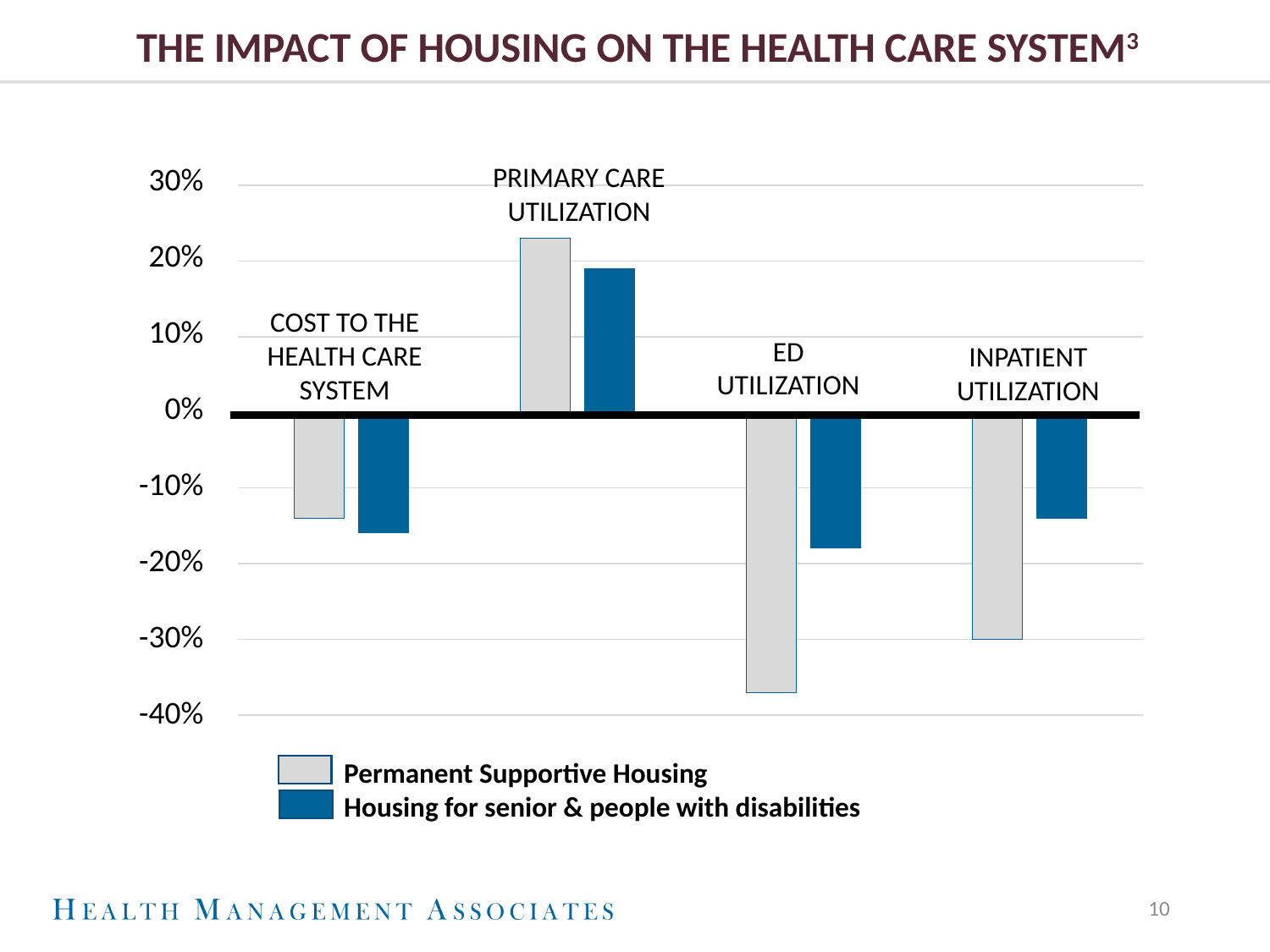
Is the Permanent Supportive Housing value for Primary Care Utilization greater or less than 20%? greater How many categories are shown on the x axis of the chart? 4 How many series does the chart's legend list? 2 Which series is shown in dark blue in the chart's legend? Housing for senior & people with disabilities Is the Permanent Supportive Housing value for Cost to the Health Care System greater or less than -10%? less What kind of chart is shown on the slide? bar chart Which category has the lowest value for Permanent Supportive Housing? ED Utilization Which category has the highest value for Permanent Supportive Housing? Primary Care Utilization Which category has the lowest value for Housing for senior & people with disabilities? ED Utilization Is the Permanent Supportive Housing value for ED Utilization greater or less than -30%? less For ED Utilization, which series has the larger reduction: Permanent Supportive Housing or Housing for senior & people with disabilities? Permanent Supportive Housing